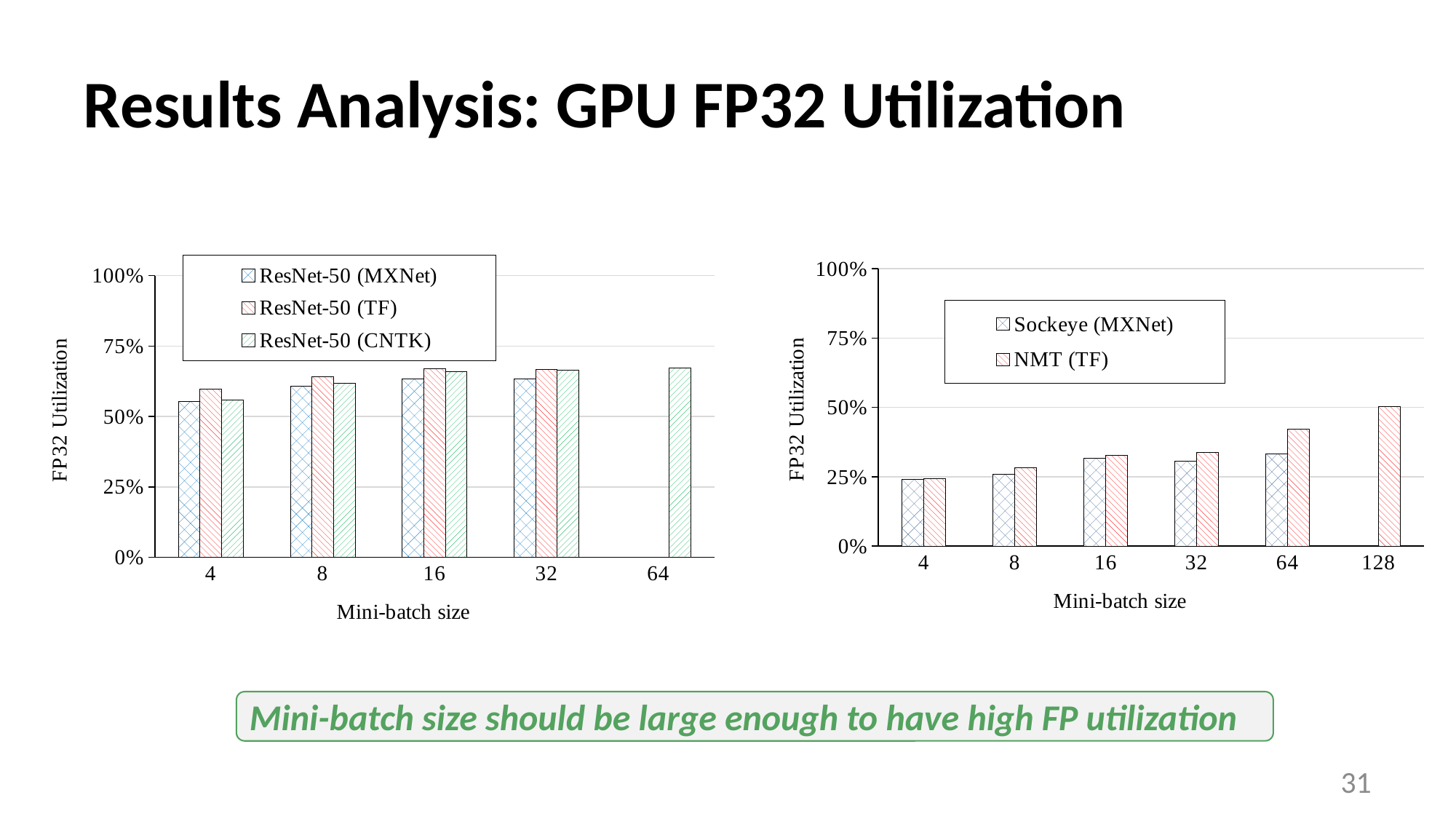
In the left chart, is the value for ResNet-50 (MXNet) at mini-batch size 4 greater or less than 50%? greater How many mini-batch sizes are shown on the x axis of the right chart? 6 In the right chart, is the value for NMT (TF) at mini-batch size 64 greater or less than 50%? less In the right chart, at mini-batch size 64, which is larger: Sockeye (MXNet) or NMT (TF)? NMT (TF) In the left chart, which series is the only one with a bar at mini-batch size 64? ResNet-50 (CNTK) How many series does the legend of the left chart list? 3 How many mini-batch sizes are shown on the x axis of the left chart? 5 In the right chart, do the NMT (TF) values rise or fall as mini-batch size increases? rise In the right chart, at which mini-batch size is NMT (TF) highest? 128 What kind of chart is the left chart (ResNet-50)? bar chart How many series does the legend of the right chart list? 2 In the right chart, is the value for Sockeye (MXNet) at mini-batch size 16 greater or less than 25%? greater